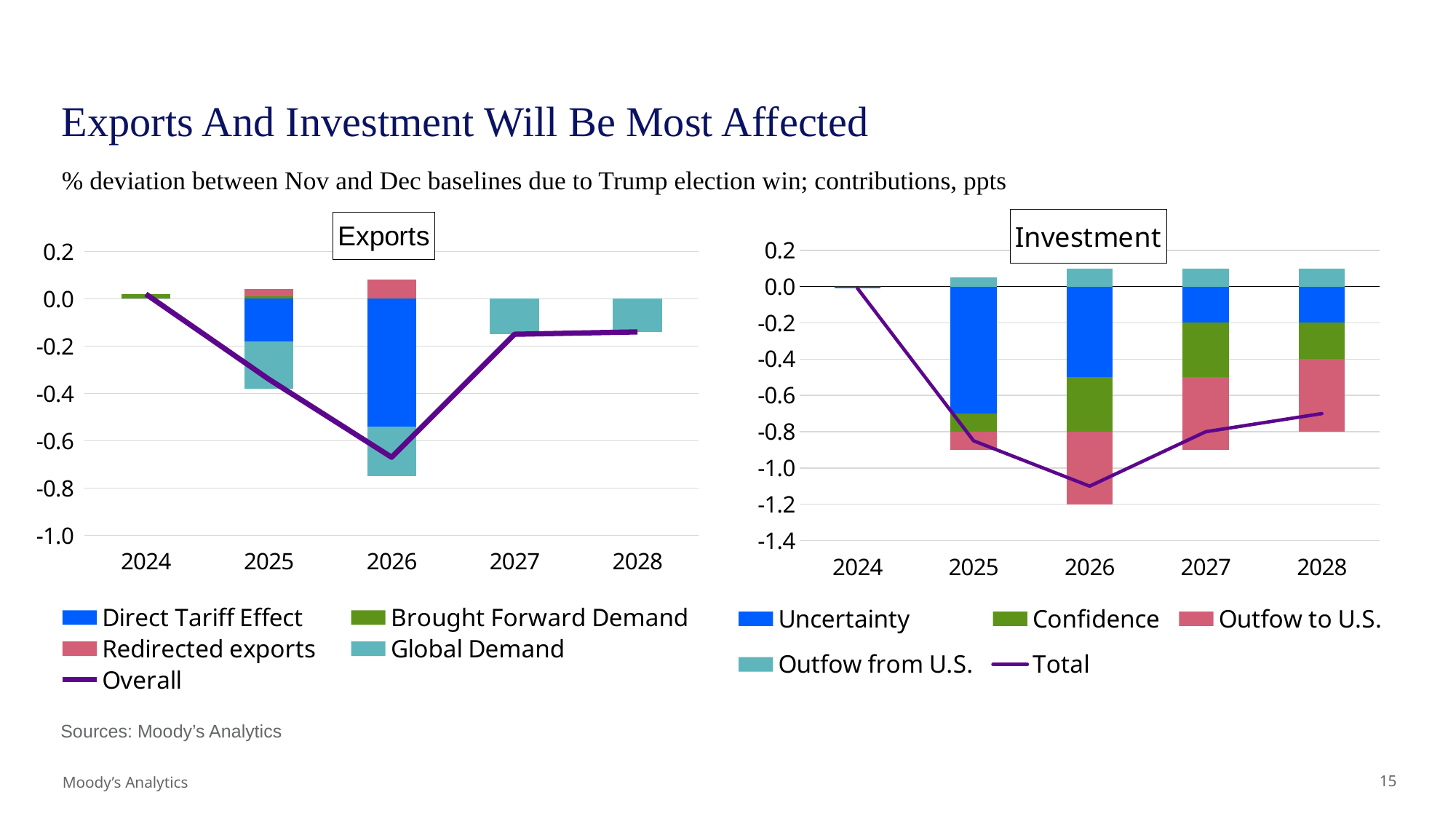
On the Investment chart, in which year does the Total line reach its lowest value? 2026 On the Exports chart, is the Overall value for 2026 greater or less than -0.6? less On the Investment chart, is the Total value for 2026 greater or less than -1.0? less On the Investment chart, is the Total value for 2028 greater or less than -0.8? greater On the Exports chart, does the Overall line rise or fall from 2024 to 2026? Fall How many entries does the legend of the Investment chart list? 5 How many years are shown on the x axis of the Exports chart? 5 On the Exports chart, in which year does the Overall line reach its lowest value? 2026 On the Exports chart, which legend entry is shown as a purple line? Overall On the Investment chart, which year has the higher Total value, 2025 or 2028? 2028 What kind of chart is the Investment chart? Stacked bar chart with a line